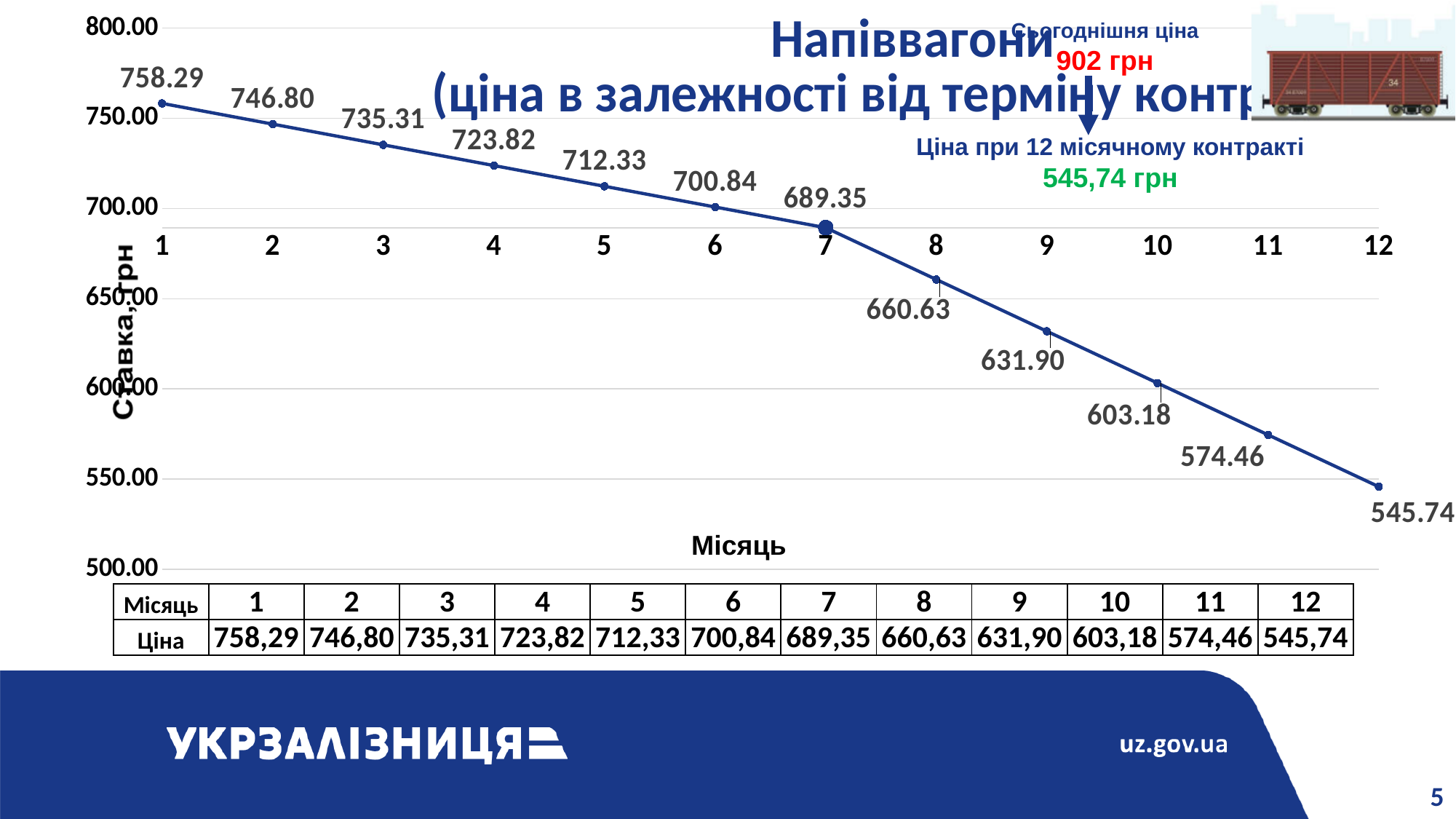
What is the value for month 9? 631.90 What kind of chart is shown on the slide? line chart What is the difference between the values for month 7 and month 8? 28.72 Do the values rise or fall as the month number increases? fall What is the value for month 7? 689.35 Which is larger, the value for month 4 or the value for month 10? month 4 How many months are plotted on the chart? 12 What is the value for month 1? 758.29 Which month has the highest value? 1 Which month has the lowest value? 12 What is the difference between the values for month 1 and month 12? 212.55 What is the value for month 12? 545.74